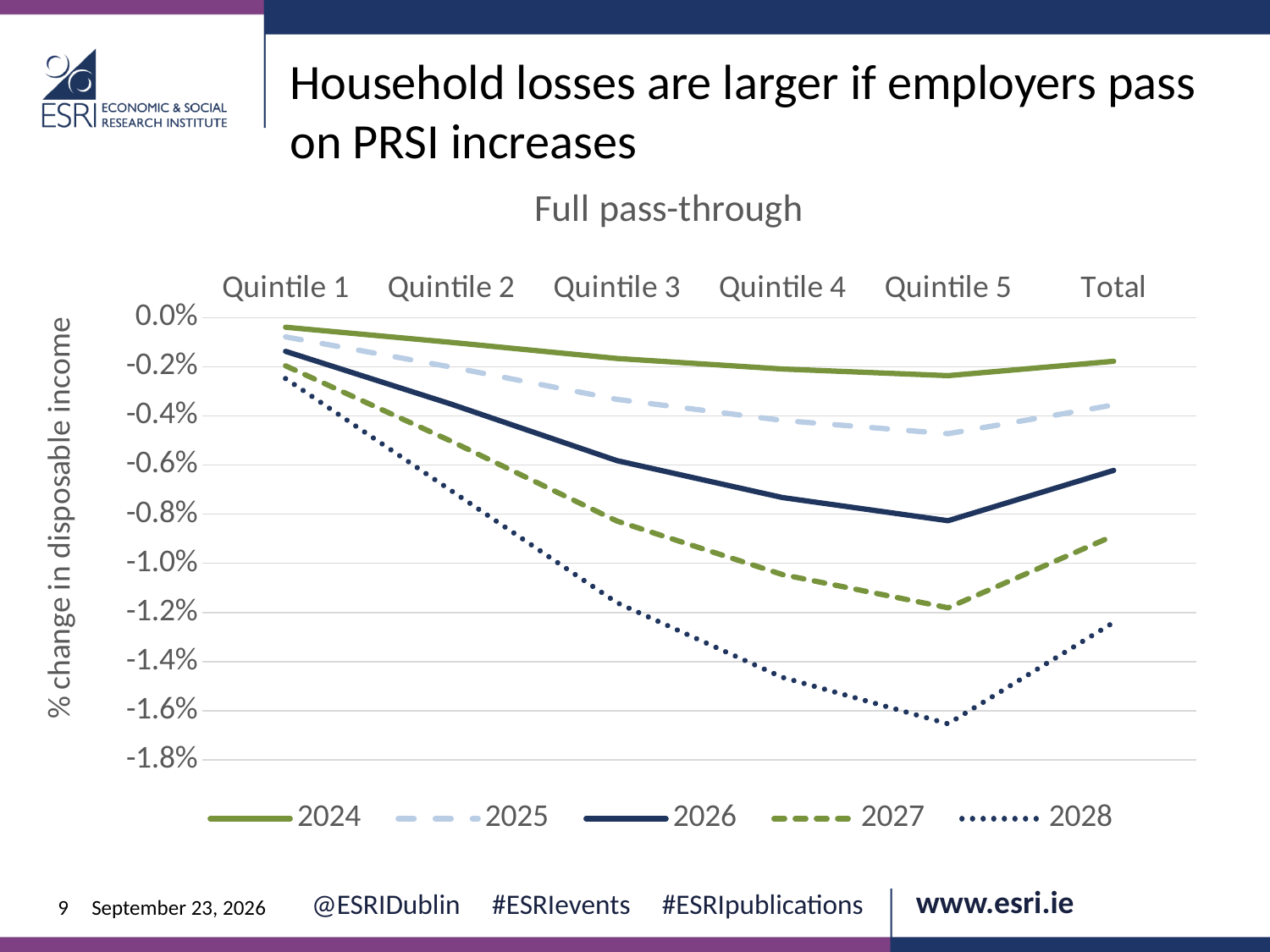
For the 2026 series, which category has the lowest value? Quintile 5 What is the title of the chart? Full pass-through How many series does the legend list? 5 How many categories are shown along the x axis? 6 Is the value for 2026 at Quintile 5 greater or less than -0.8%? less What is the label on the vertical axis? % change in disposable income Is the value for 2025 at Quintile 5 greater or less than -0.4%? less Which series has the lowest value at Quintile 5? 2028 Do the values for the 2028 series rise or fall from Quintile 1 to Quintile 5? fall Is the value for 2028 at Quintile 5 greater or less than -1.6%? less What kind of chart is shown on the slide? line chart